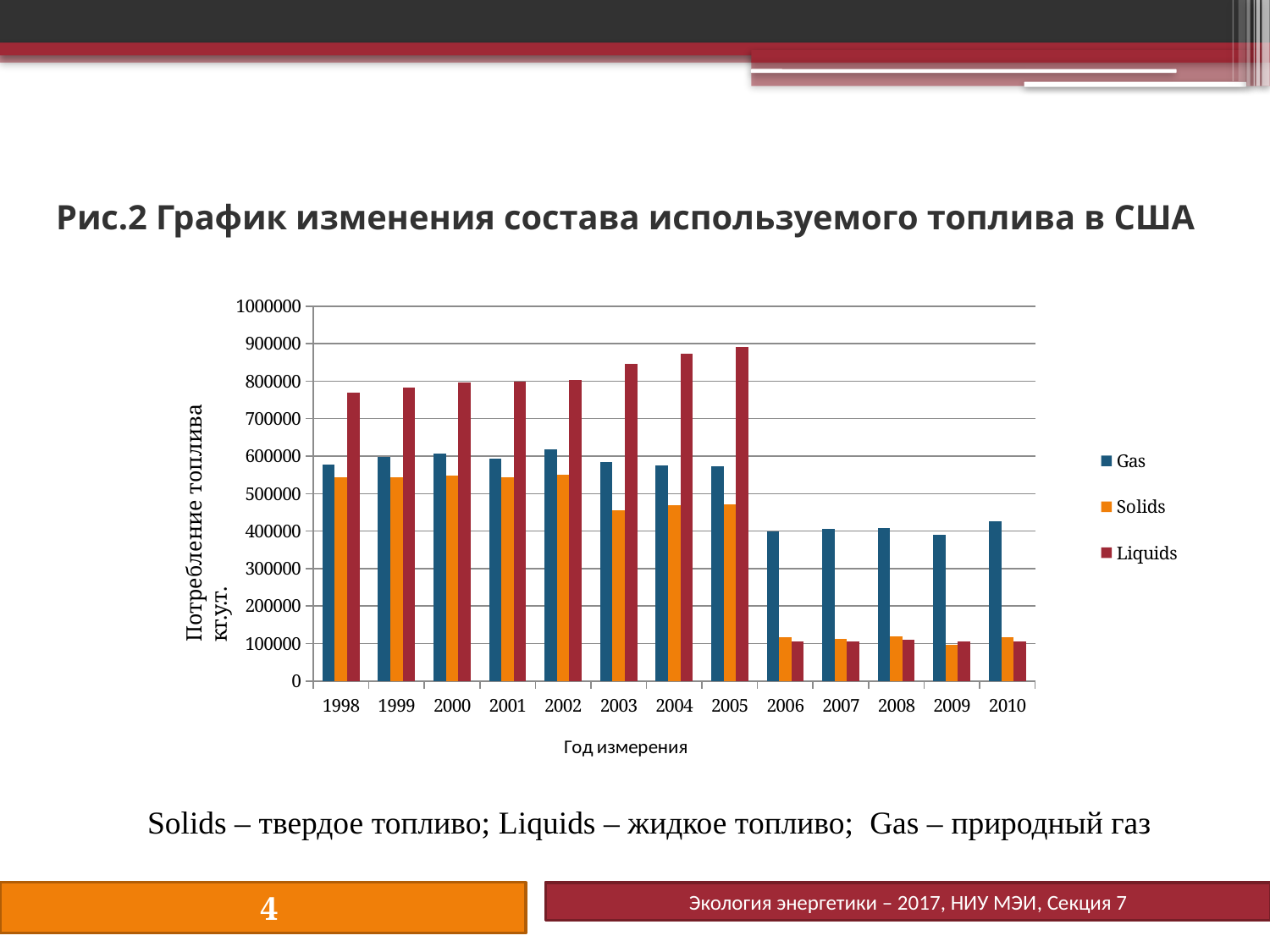
What kind of chart is shown on the slide? bar chart Is the Solids value for 1998 greater or less than 500000? greater How many years are shown on the x axis? 13 In which year is the Liquids value highest? 2005 In which year is the Gas value lowest? 2009 What is the title of the x axis? Год измерения How many series does the legend list? 3 Do the Liquids values rise or fall from 1998 to 2005? rise Which is larger in 2004, the Gas value or the Liquids value? Liquids In which year is the Solids value lowest? 2009 Is the Liquids value for 2005 greater or less than 800000? greater Is the Gas value for 2006 greater or less than 500000? less